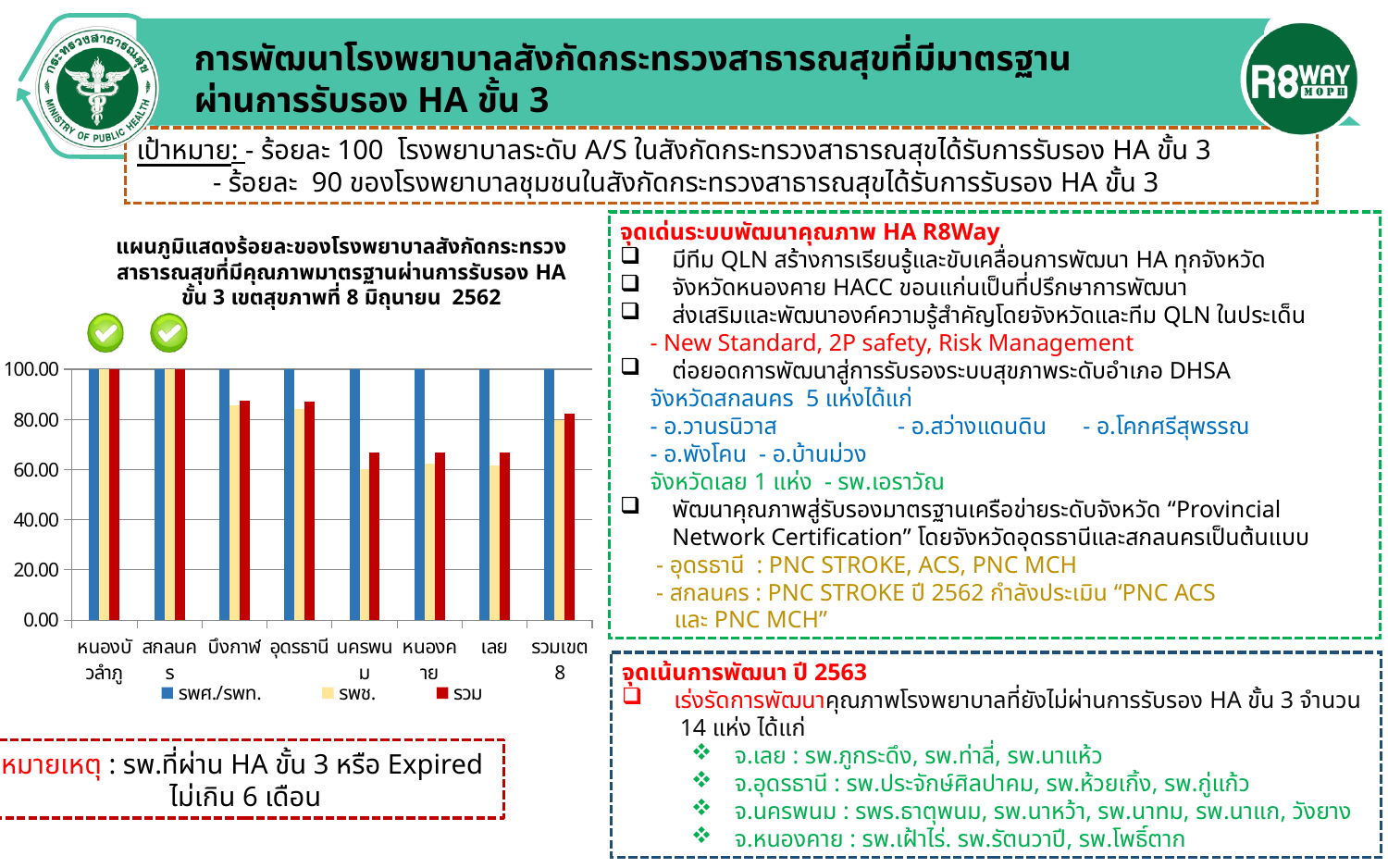
Is the value of the รพช. series for บึงกาฬ greater or less than 60.00? greater Is the value of the รพช. series for นครพนม greater or less than 80.00? less What is the value of the รพศ./รพท. series for หนองบัวลำภู in the bar chart? 100.00 Is the value of the รวม series for เลย greater or less than 80.00? less What are the three series listed in the legend of the bar chart? รพศ./รพท., รพช., รวม Which colour represents the รวม series in the bar chart? red What is the value of the รพช. series for สกลนคร in the bar chart? 100.00 What kind of chart is shown on the left of the slide? bar chart Which is larger in the bar chart: the รพช. value for หนองบัวลำภู or the รพช. value for นครพนม? หนองบัวลำภู How many categories are shown along the x axis of the bar chart? 8 How many series does the legend of the bar chart list? 3